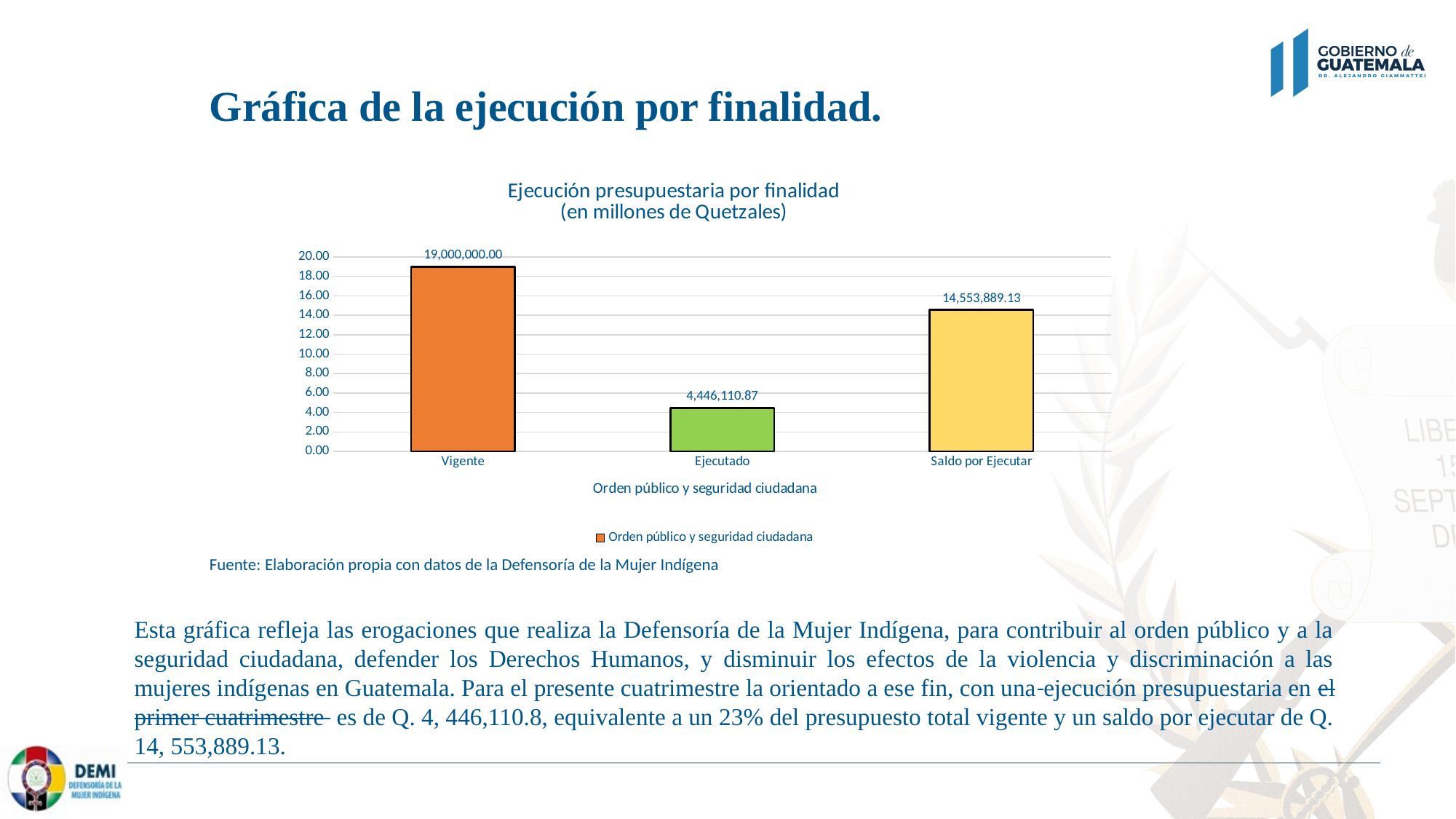
What kind of chart is shown on the slide? bar chart What is the difference between the Saldo por Ejecutar value and the Ejecutado value? 10,107,778.26 Is the value for Ejecutado greater or less than 6.00 on the axis? less Which category has the highest value? Vigente What is the difference between the Vigente value and the Ejecutado value? 14,553,889.13 What is the value shown for Ejecutado? 4,446,110.87 What is the value shown for Saldo por Ejecutar? 14,553,889.13 What is the single entry listed in the chart legend? Orden público y seguridad ciudadana Which is larger, the value for Saldo por Ejecutar or the value for Ejecutado? Saldo por Ejecutar What is the value shown for Vigente? 19,000,000.00 Which category has the lowest value? Ejecutado How many categories are shown on the x axis? 3